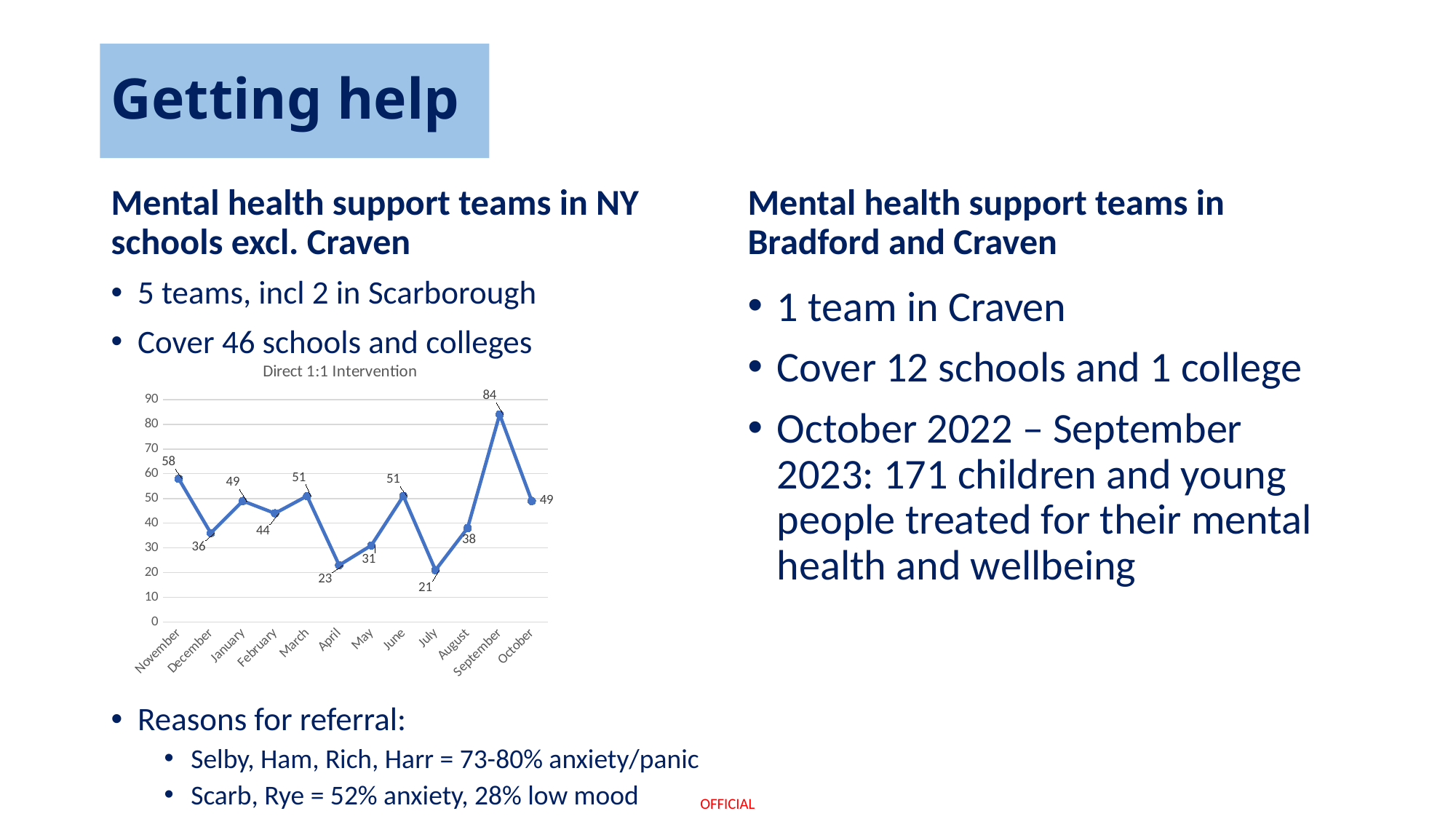
What is the value for July in the Direct 1:1 Intervention chart? 21 How many months are plotted in the Direct 1:1 Intervention chart? 12 Which month has the lowest value in the Direct 1:1 Intervention chart? July What is the title of the chart on the slide? Direct 1:1 Intervention Which is larger in the Direct 1:1 Intervention chart, the value for March or the value for April? March What is the difference between the September and August values in the Direct 1:1 Intervention chart? 46 What is the value for September in the Direct 1:1 Intervention chart? 84 What is the value for November in the Direct 1:1 Intervention chart? 58 Does the value rise or fall from August to September in the Direct 1:1 Intervention chart? rise What kind of chart is the Direct 1:1 Intervention chart? line chart Which month has the highest value in the Direct 1:1 Intervention chart? September Is the value for December in the Direct 1:1 Intervention chart greater or less than 40? less